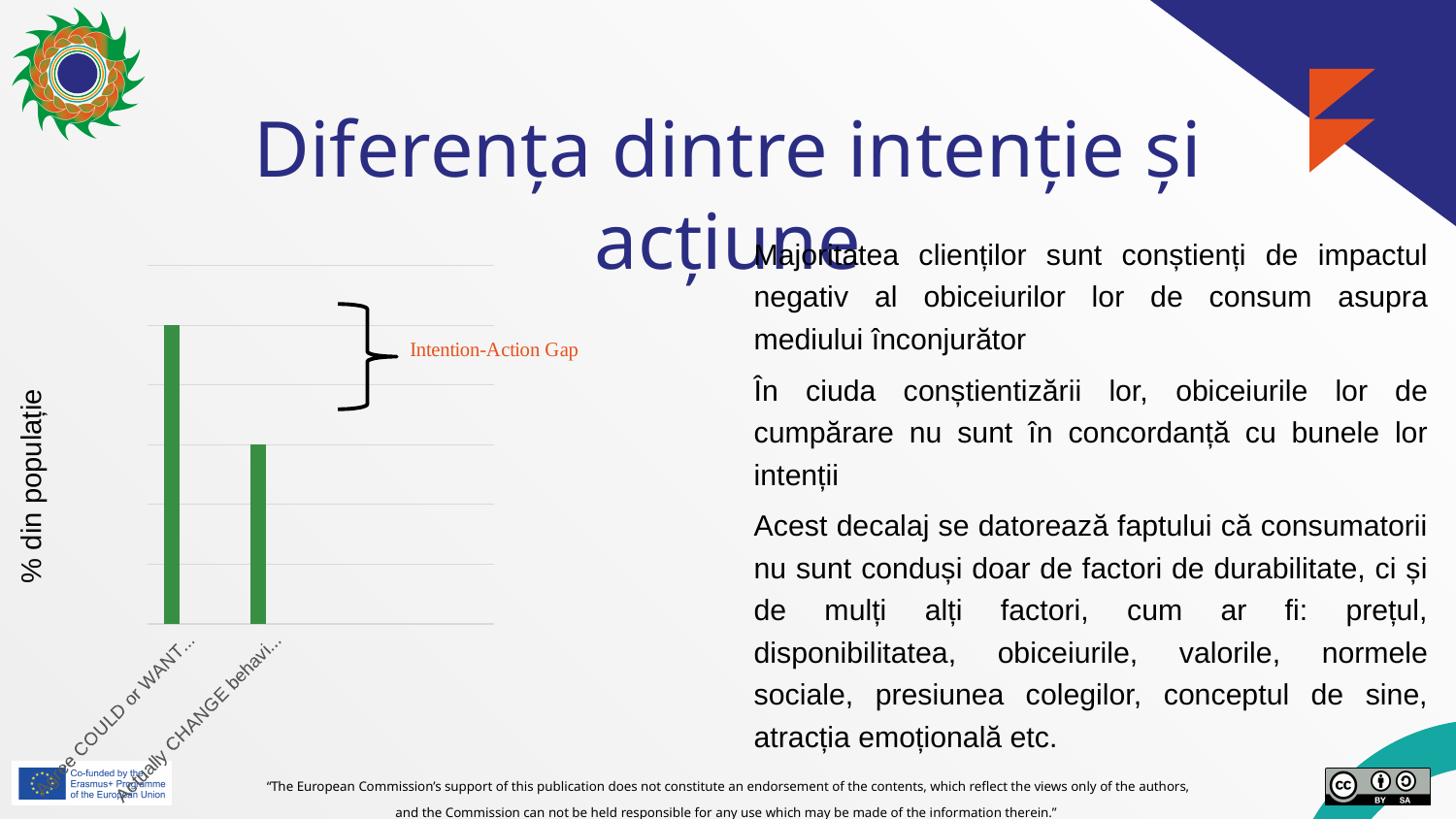
What is the label on the vertical axis of the chart? % din populație How many bars are plotted in the chart? 2 What kind of chart is shown on the slide? bar chart Which bar is taller, the left bar or the right bar? the left bar What text is written next to the bracket between the two bars in the chart? Intention-Action Gap Do the bar values rise or fall from left to right along the x axis? fall